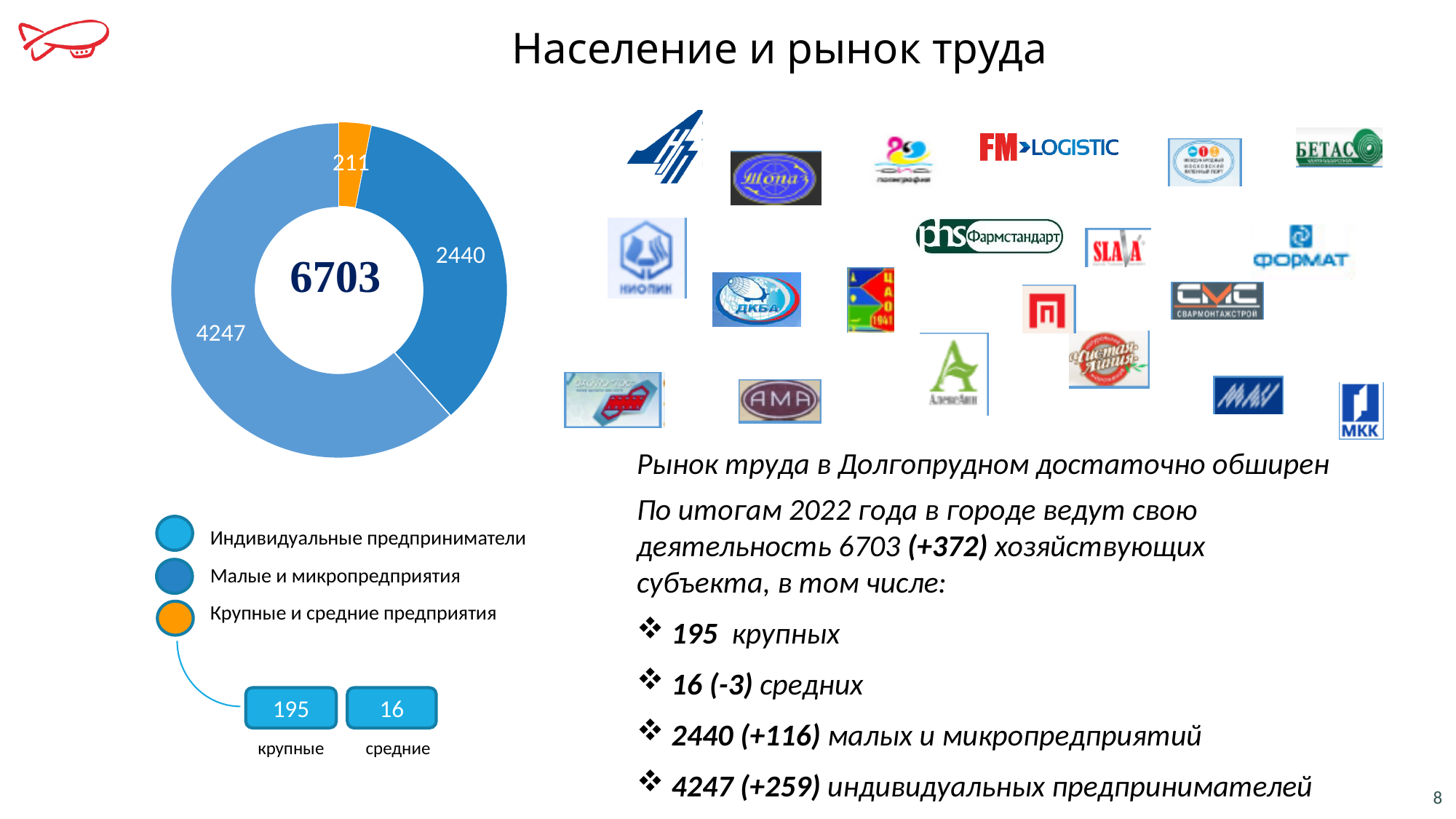
How many categories does the donut chart show? 3 What value is shown for Крупные и средние предприятия in the donut chart? 211 Which category has the largest segment in the donut chart? Индивидуальные предприниматели What is the difference between the values for Малые и микропредприятия and Крупные и средние предприятия? 2229 What value is shown for Индивидуальные предприниматели in the donut chart? 4247 Which is larger: the value for Малые и микропредприятия or the value for Крупные и средние предприятия? Малые и микропредприятия What value is shown for Малые и микропредприятия in the donut chart? 2440 Which category has the smallest segment in the donut chart? Крупные и средние предприятия What colour is the segment for Крупные и средние предприятия? Orange What is the difference between the values for Индивидуальные предприниматели and Малые и микропредприятия? 1807 What kind of chart is shown on the slide? Donut (pie) chart What total is shown in the centre of the donut chart? 6703